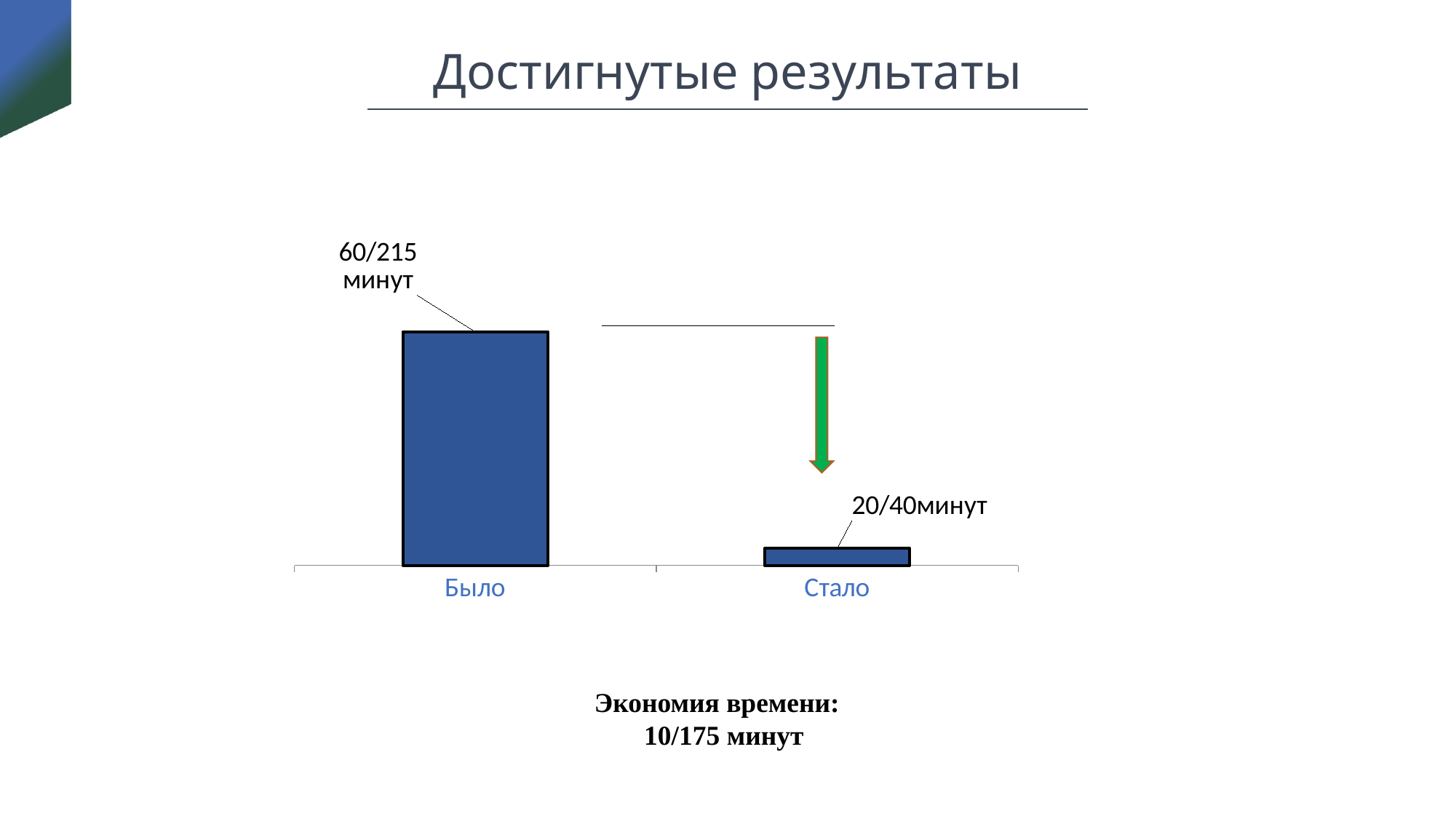
What kind of chart is shown on the slide? bar chart What is the title of the slide containing the chart? Достигнутые результаты How many categories are shown on the x axis of the chart? 2 Which category has the taller bar? Было What is the data label on the bar for Было? 60/215 минут Which category has the shorter bar? Стало What is the data label on the bar for Стало? 20/40минут What time saving is stated in the text below the chart? 10/175 минут Is the bar for Было taller or shorter than the bar for Стало? taller Do the bar values rise or fall from Было to Стало? fall